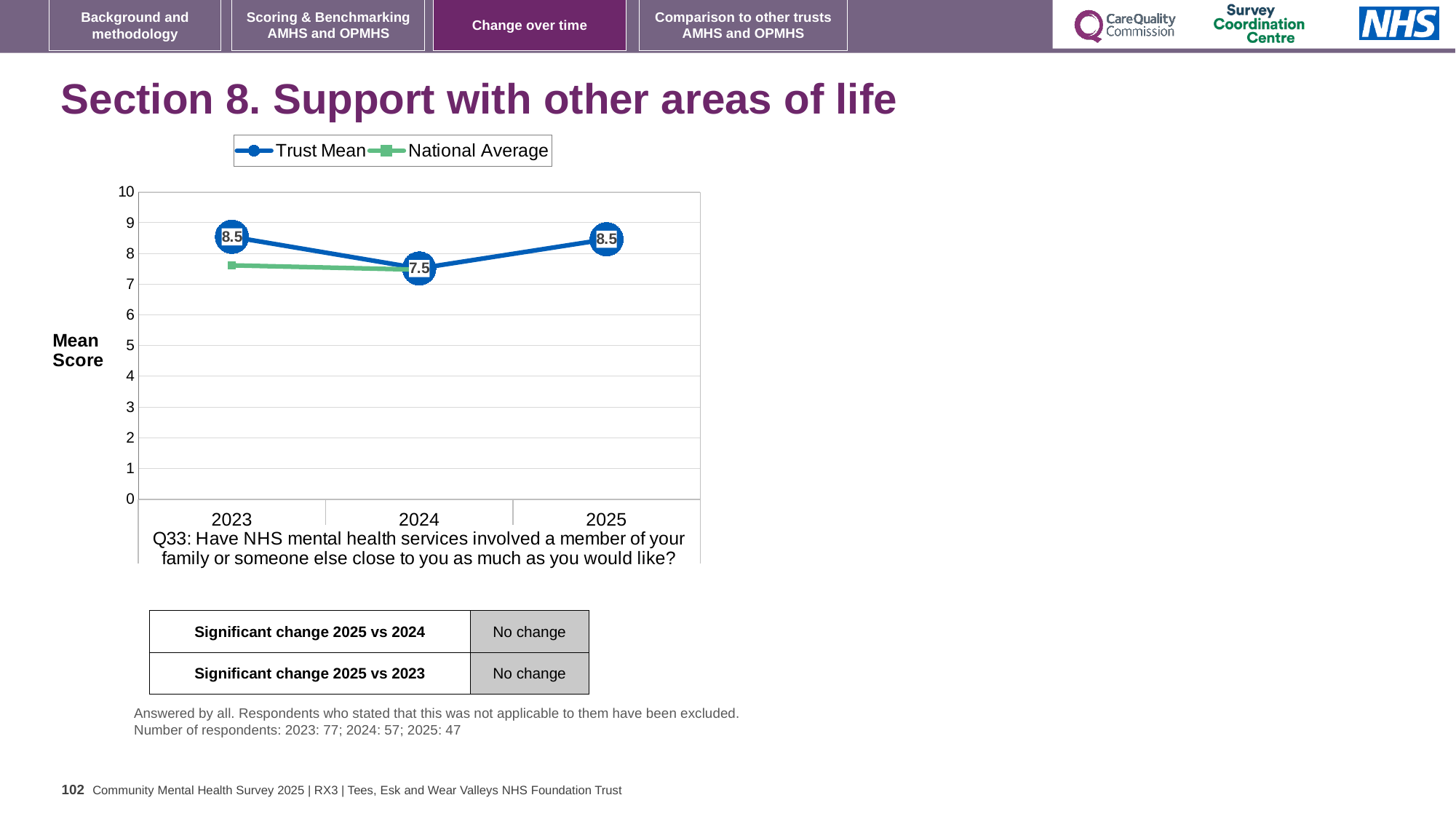
How many series does the chart legend list? 2 In 2023, which series has the higher value, Trust Mean or National Average? Trust Mean How many years are shown on the x axis of the chart? 3 What is the Trust Mean score for 2025? 8.5 In which year is the Trust Mean score lowest? 2024 What is the Trust Mean score for 2023? 8.5 Which is larger, the Trust Mean score for 2024 or for 2025? 2025 Is the National Average value for 2023 greater or less than 8? less What kind of chart is shown on the slide? line chart What is the difference between the Trust Mean scores for 2023 and 2024? 1.0 What is the Trust Mean score for 2024? 7.5 What is the label on the y axis of the chart? Mean Score